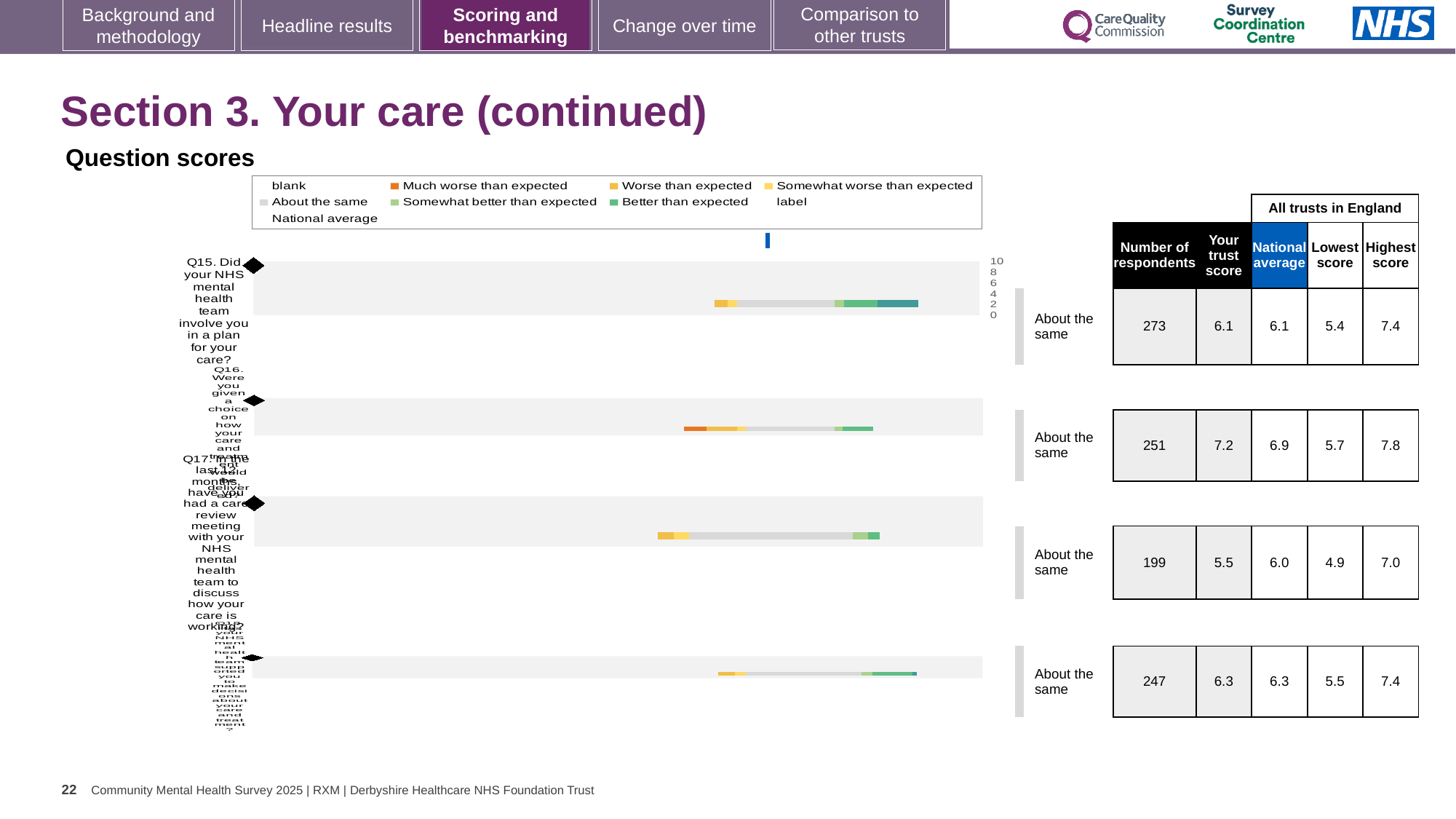
What benchmark category is shown for Q16? About the same Which question has the highest trust score? Q16 How many questions (rows) are plotted in the question scores chart? 4 Which question has the lowest trust score? Q17 What is the national average score for Q15 (involved in a plan for your care)? 6.1 What is the trust score for Q16 (choice on how care and treatment would be delivered)? 7.2 By how much does the trust score for Q16 exceed the national average for Q16? 0.3 What is the highest score across all trusts in England for the bottom row (fourth question) of the chart? 7.4 What is the difference between the highest score and the lowest score for Q17? 2.1 How many respondents answered Q17 (care review meeting in the last 12 months)? 199 For Q17, which is larger: the trust score or the national average? National average What kind of chart is used to show the question scores on this slide? bar chart